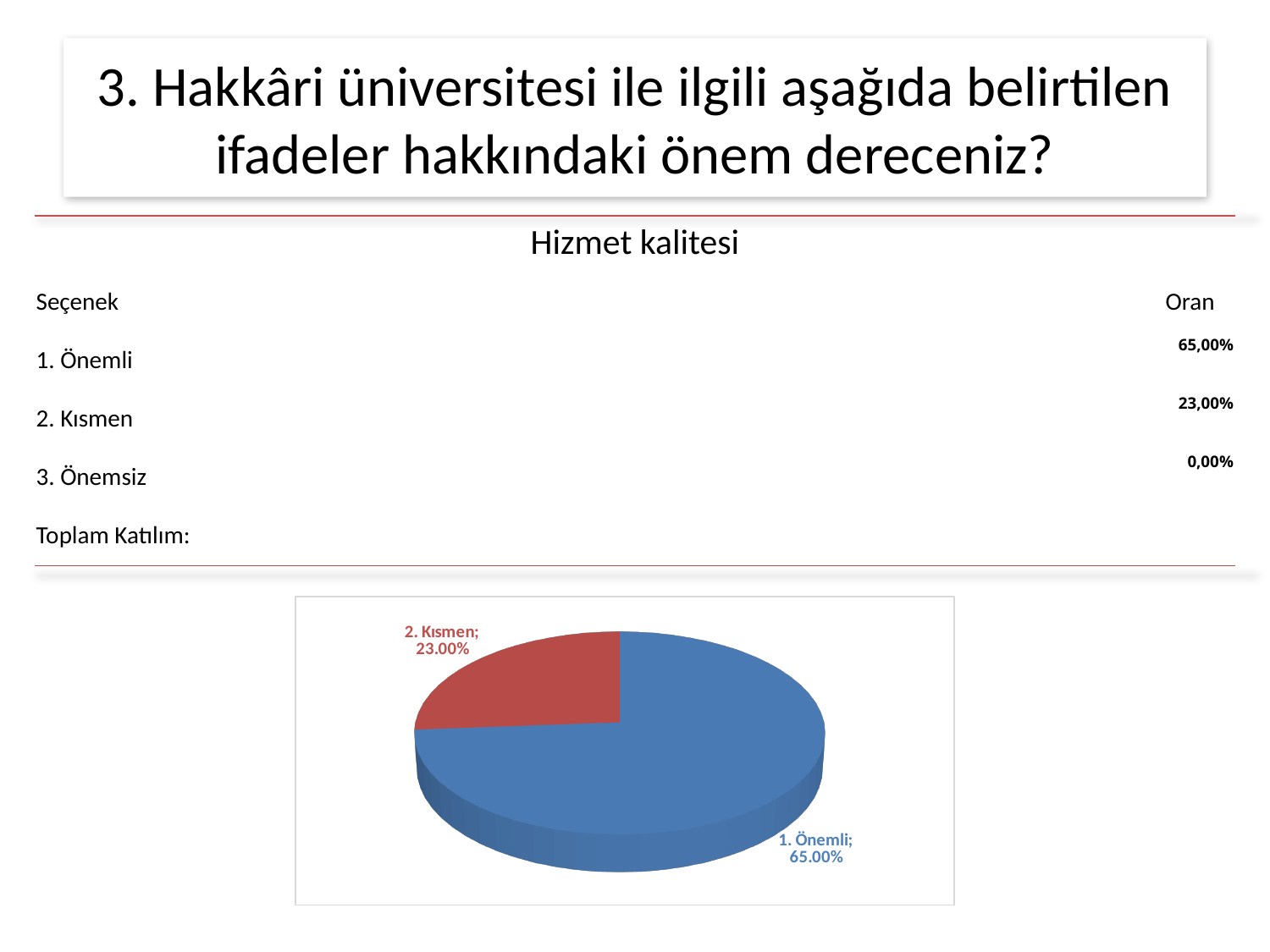
What share of the pie does the "2. Kısmen" slice represent? 23.00% What is the difference between the "1. Önemli" and "2. Kısmen" shares in the pie chart? 42.00% What colour is the "2. Kısmen" slice in the pie chart? red Which labeled slice of the pie chart is the smallest? 2. Kısmen Which slice of the pie chart is the largest? 1. Önemli Which is larger in the pie chart, "1. Önemli" or "2. Kısmen"? 1. Önemli What kind of chart is shown on the slide? pie chart What colour is the "1. Önemli" slice in the pie chart? blue What percentage does the pie chart show for "1. Önemli"? 65.00% What percentage does the pie chart show for "2. Kısmen"? 23.00% How many labeled slices does the pie chart show? 2